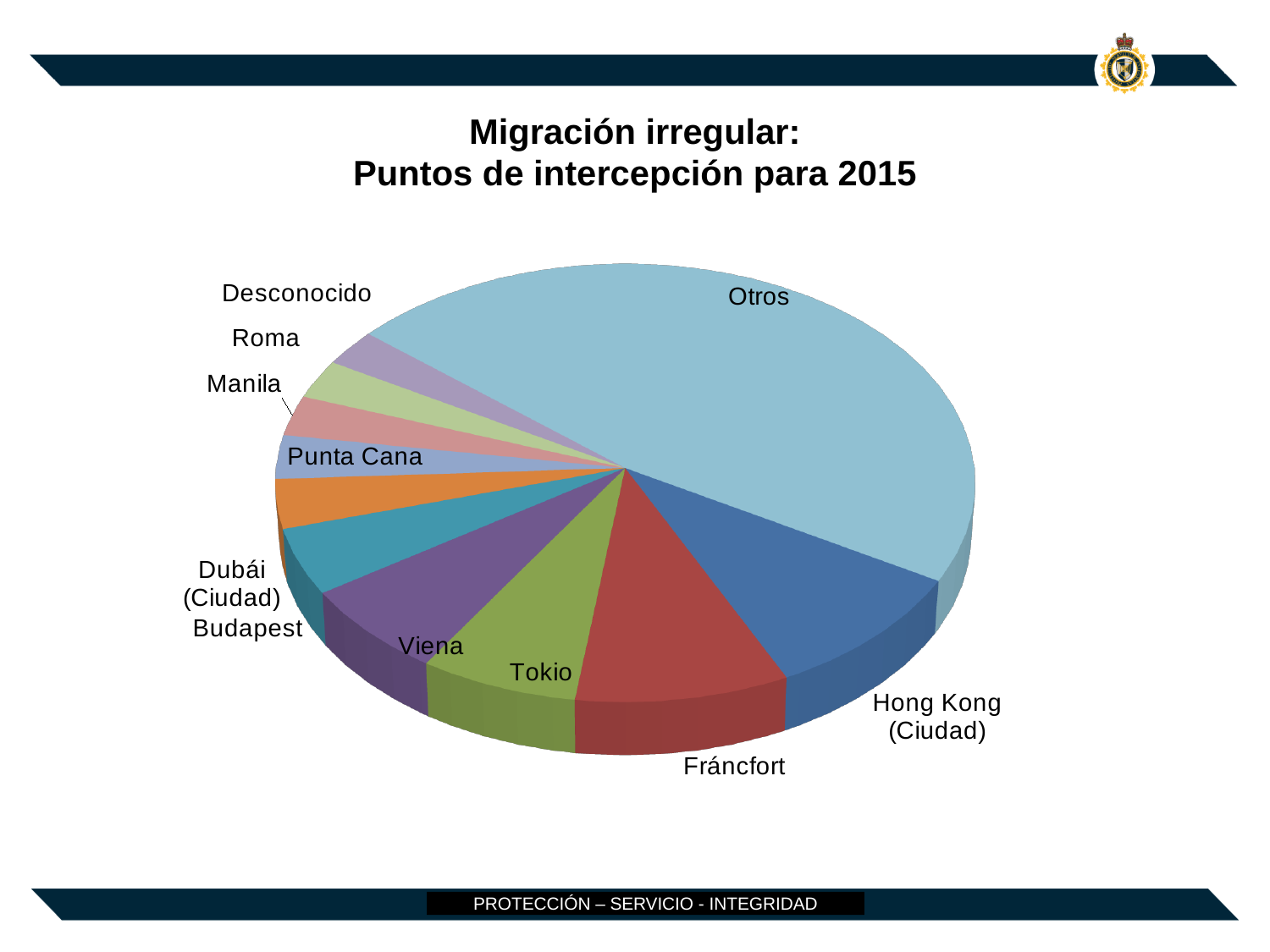
How many slices (categories) does the pie chart have? 11 Which category has the largest slice of the pie? Otros What kind of chart is shown on the slide? Pie chart What colour is the Otros slice? Light blue Which slice is larger, Hong Kong (Ciudad) or Budapest? Hong Kong (Ciudad) Which slice is larger, Hong Kong (Ciudad) or Tokio? Hong Kong (Ciudad) Which slice is larger, Otros or Fráncfort? Otros What is the title of the chart? Migración irregular: Puntos de intercepción para 2015